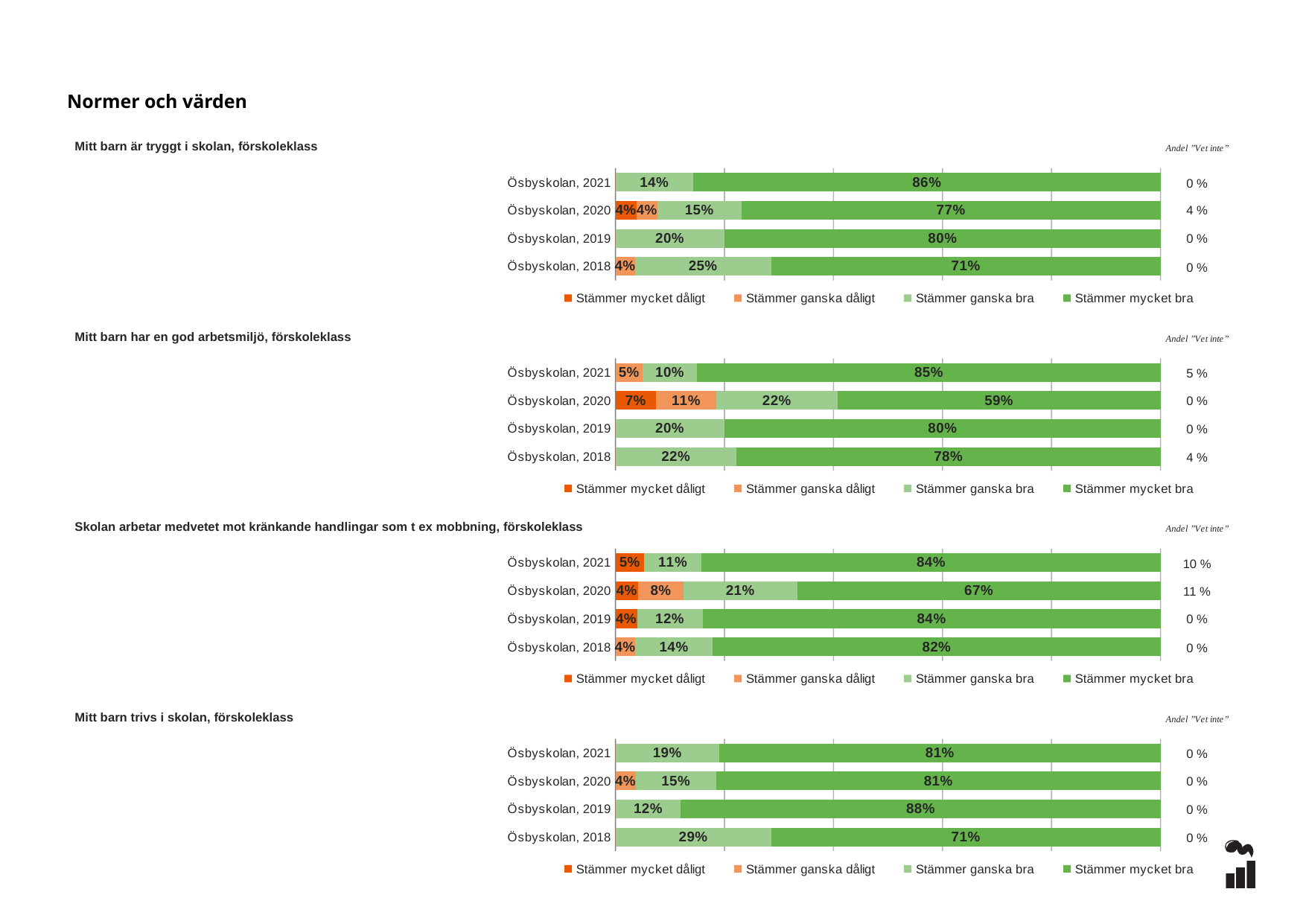
In the chart 'Mitt barn är tryggt i skolan, förskoleklass', what is the value of 'Stämmer mycket bra' for Ösbyskolan, 2021? 86% How many categories (bars) are shown in the chart 'Mitt barn är tryggt i skolan, förskoleklass'? 4 What kind of chart is 'Mitt barn har en god arbetsmiljö, förskoleklass'? Stacked bar chart In the chart 'Mitt barn trivs i skolan, förskoleklass', is the 'Stämmer ganska bra' value larger for Ösbyskolan, 2018 or Ösbyskolan, 2019? Ösbyskolan, 2018 In the chart 'Mitt barn är tryggt i skolan, förskoleklass', which year has the lowest 'Stämmer mycket bra' value? Ösbyskolan, 2018 In the chart 'Mitt barn trivs i skolan, förskoleklass', what is the value of 'Stämmer mycket bra' for Ösbyskolan, 2019? 88% In the chart 'Mitt barn har en god arbetsmiljö, förskoleklass', what is the difference between the 'Stämmer mycket bra' values for Ösbyskolan, 2021 and Ösbyskolan, 2020? 26% In the chart 'Mitt barn har en god arbetsmiljö, förskoleklass', what is the value of 'Stämmer mycket dåligt' for Ösbyskolan, 2020? 7% In the chart 'Skolan arbetar medvetet mot kränkande handlingar som t ex mobbning, förskoleklass', what is the 'Andel "Vet inte"' value for Ösbyskolan, 2020? 11 % In the chart 'Skolan arbetar medvetet mot kränkande handlingar som t ex mobbning, förskoleklass', what is the value of 'Stämmer ganska bra' for Ösbyskolan, 2020? 21% In the chart 'Skolan arbetar medvetet mot kränkande handlingar som t ex mobbning, förskoleklass', which year has the highest 'Stämmer ganska bra' value? Ösbyskolan, 2020 How many series does the legend list in the chart 'Mitt barn trivs i skolan, förskoleklass'? 4